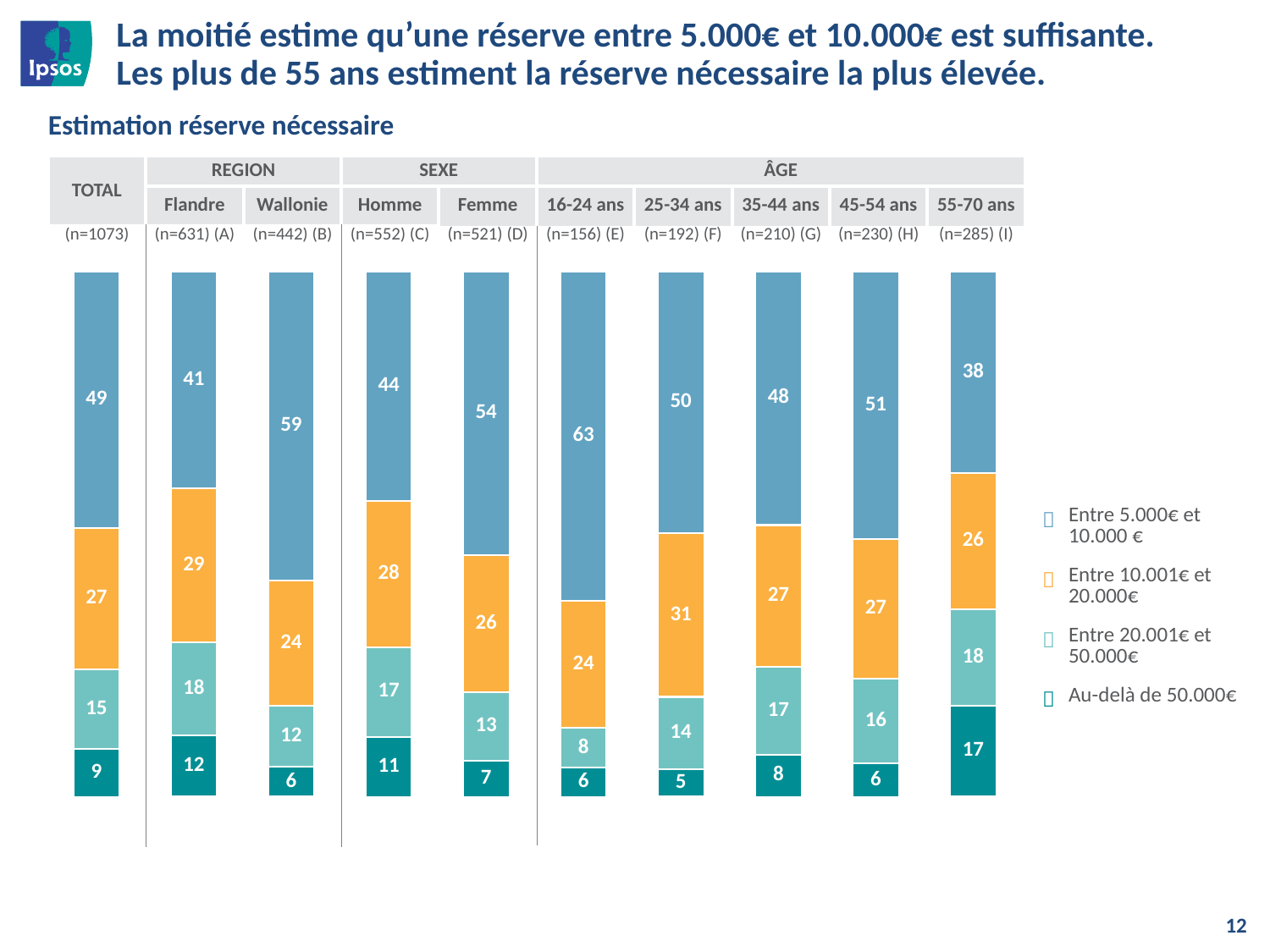
Which is larger for 'Entre 20.001€ et 50.000€': Homme or Femme? Homme What kind of chart is shown on the slide? Stacked bar chart What is the value for 'Au-delà de 50.000€' for the 55-70 ans group? 17 How many bars (categories) are shown in the chart? 10 What is the value for 'Entre 5.000€ et 10.000 €' in the TOTAL bar? 49 Which category has the lowest value for 'Au-delà de 50.000€'? 25-34 ans Which category has the lowest value for 'Entre 5.000€ et 10.000 €'? 55-70 ans What is the value for 'Entre 10.001€ et 20.000€' for Flandre? 29 How many series does the legend list? 4 What is the difference between Wallonie and Flandre for 'Entre 5.000€ et 10.000 €'? 18 Which category has the highest value for 'Entre 5.000€ et 10.000 €'? 16-24 ans What is the total of the stacked bar for 16-24 ans? 101